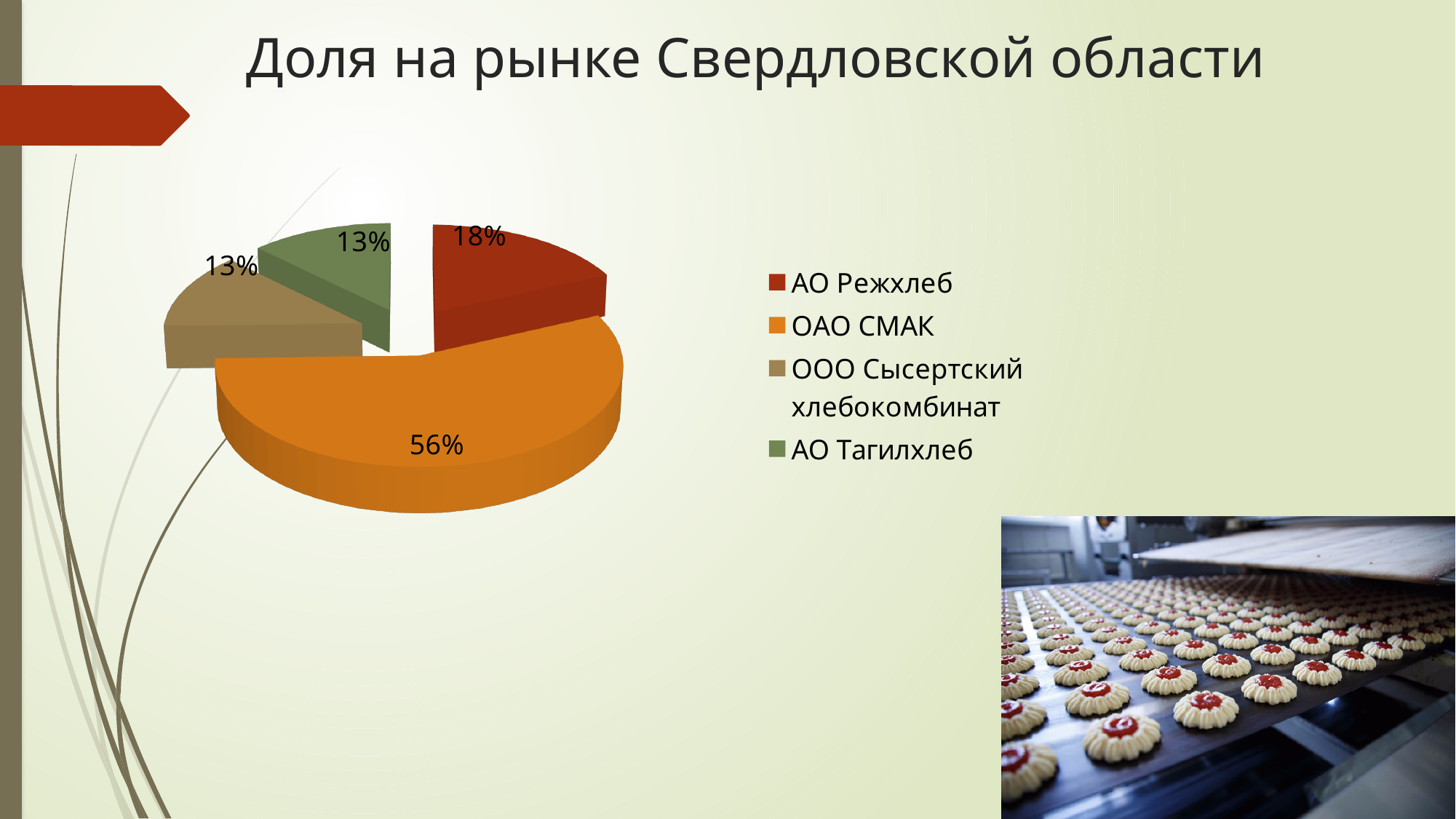
What share of the market does ООО Сысертский хлебокомбинат hold? 13% Which is larger, the share of АО Режхлеб or the share of АО Тагилхлеб? АО Режхлеб What is the title of the chart? Доля на рынке Свердловской области What share of the market does АО Тагилхлеб hold? 13% What kind of chart is shown on the slide? Pie chart Which company is represented by the orange slice? ОАО СМАК What is the combined share of ООО Сысертский хлебокомбинат and АО Тагилхлеб? 26% What is the difference between the shares of ОАО СМАК and АО Режхлеб? 38% Which company has the largest market share? ОАО СМАК How many companies are shown in the pie chart? 4 What share of the market does АО Режхлеб hold? 18% What share of the market does ОАО СМАК hold? 56%